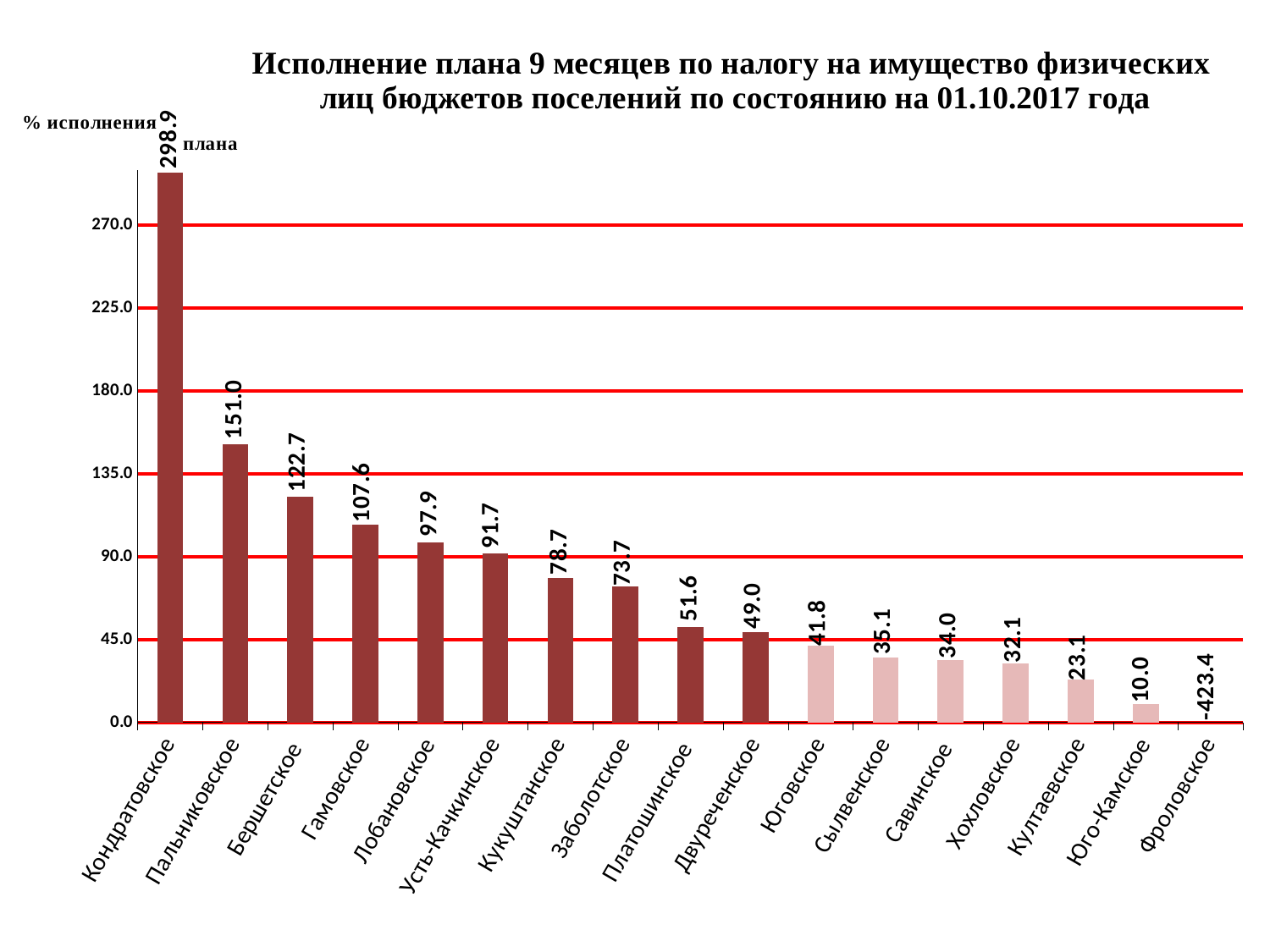
Do the values rise or fall from left to right along the x axis? fall What is the value for Юго-Камское? 10.0 What is the difference between the values for Кондратовское and Пальниковское? 147.9 What is the value for Лобановское? 97.9 How many settlements are shown on the x axis? 17 What is the difference between the values for Пальниковское and Бершетское? 28.3 Which settlement has the lowest value? Фроловское What type of chart is shown on the slide? bar chart What is the value for Кондратовское? 298.9 Which settlement has the highest value? Кондратовское What is the value for Фроловское? -423.4 Which is larger, the value for Гамовское or the value for Усть-Качкинское? Гамовское